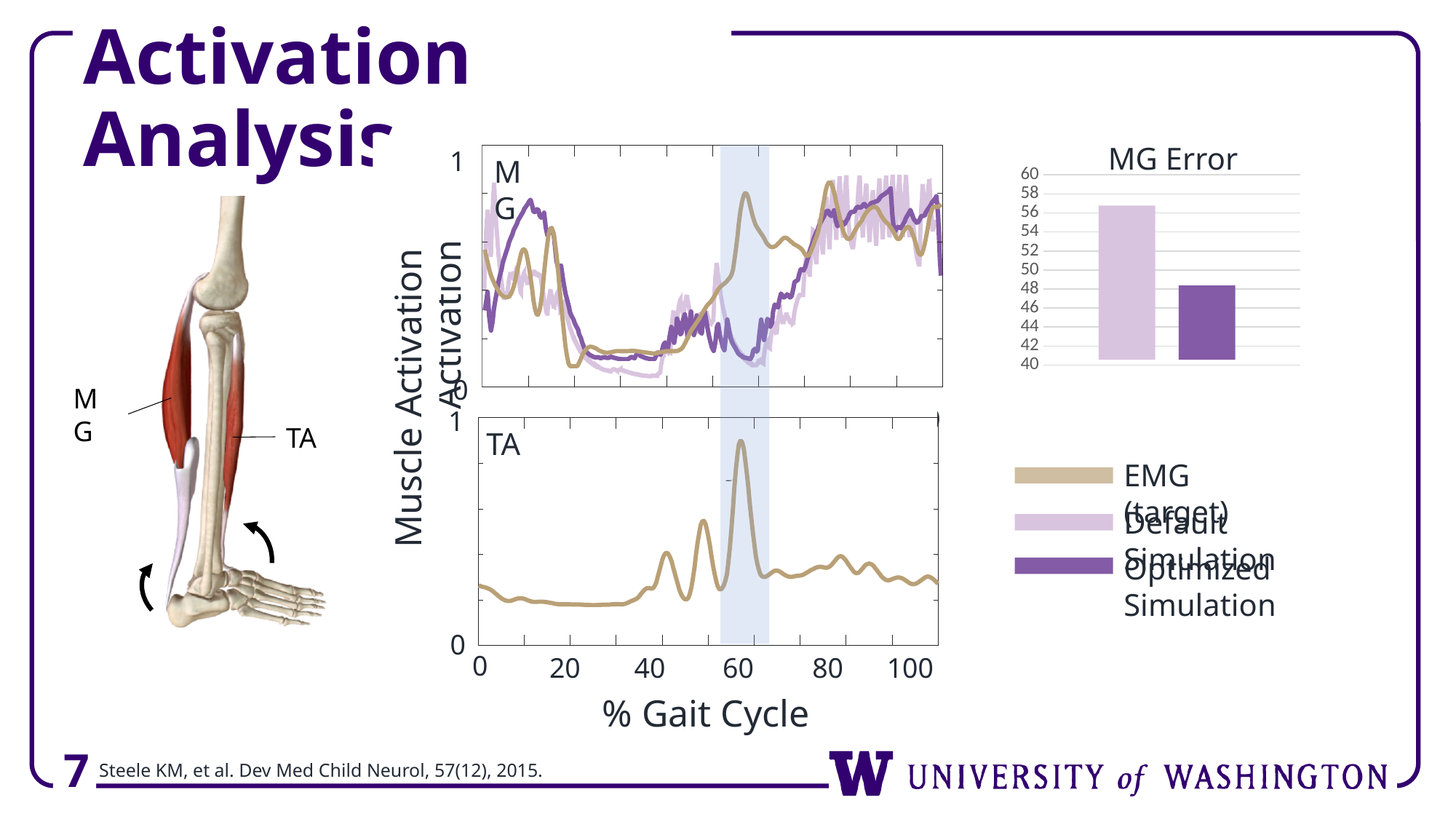
What is the x-axis label of the muscle activation line charts? % Gait Cycle In the "MG Error" chart, is the value of the darker purple bar greater or less than 50? less In the "TA" chart, does the activation rise or fall between 40% and 60% of the gait cycle? rise In the "MG Error" chart, is the value of the lighter purple bar greater or less than 54? greater In the "TA" chart, is the peak activation value greater or less than 0.5? greater What is the lowest value shown on the vertical axis of the "MG Error" chart? 40 How many bars are shown in the "MG Error" chart? 2 How many entries does the legend next to the muscle activation charts list? 3 What kind of chart is the "MG Error" chart? bar chart In the "MG Error" chart, which bar is taller, the lighter purple bar or the darker purple bar? the lighter purple bar What kind of chart is the "TA" muscle activation chart? line chart